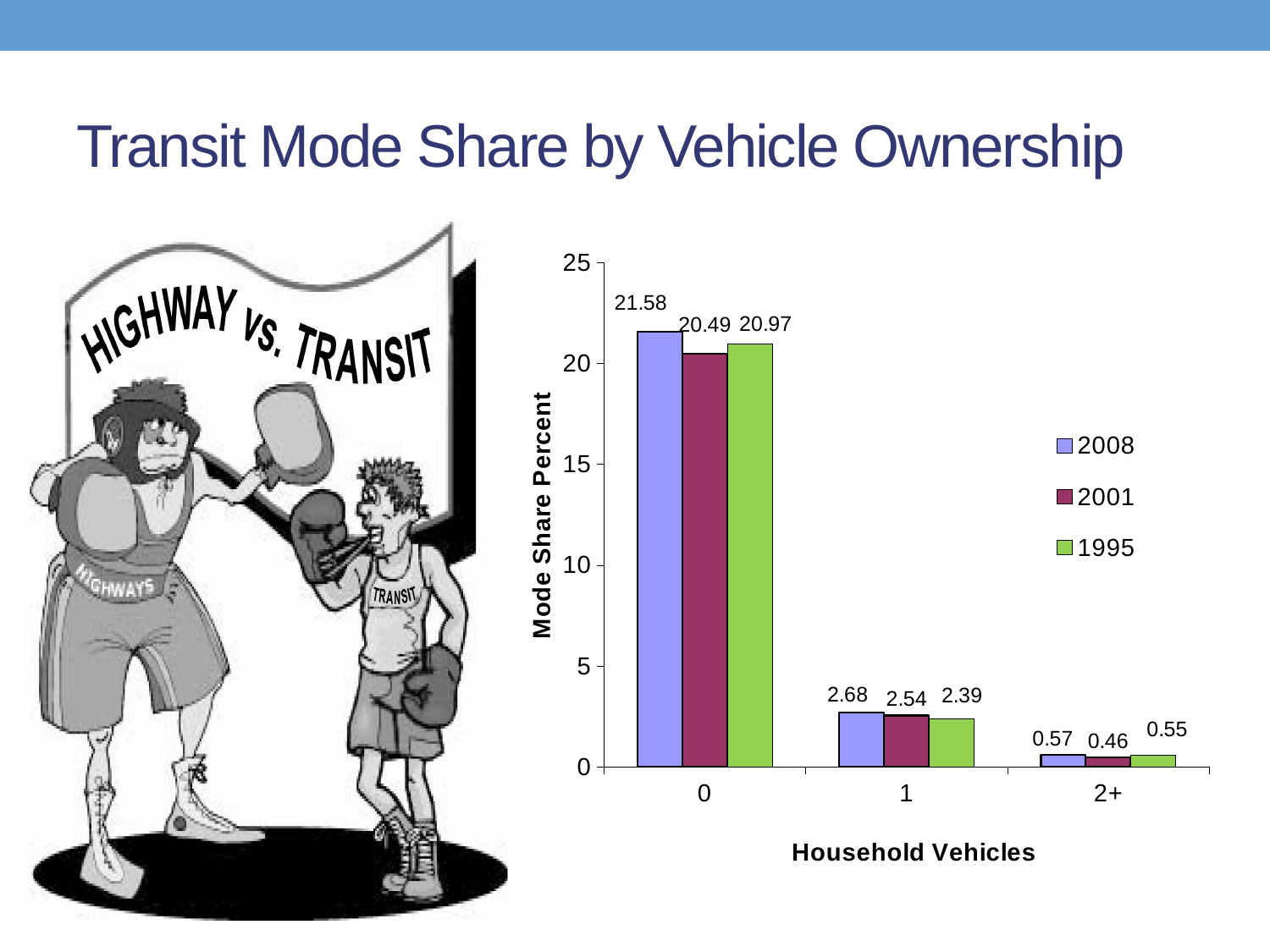
What is the label of the y axis? Mode Share Percent For households with 1 vehicle, which year has the larger mode share percent, 2008 or 1995? 2008 What is the mode share percent for households with 1 vehicle in 1995? 2.39 Is the 1995 mode share percent for households with 0 vehicles greater or less than 20? greater What is the mode share percent for households with 2+ vehicles in 2001? 0.46 What kind of chart is shown on the slide? Bar chart Which household vehicle category has the highest mode share percent in 2008? 0 What is the difference between the 2008 and 2001 mode share percent for households with 0 vehicles? 1.09 How many household vehicle categories are shown on the x axis? 3 Which household vehicle category has the lowest mode share percent in 1995? 2+ What is the mode share percent for households with 0 vehicles in 2008? 21.58 How many series does the legend list? 3